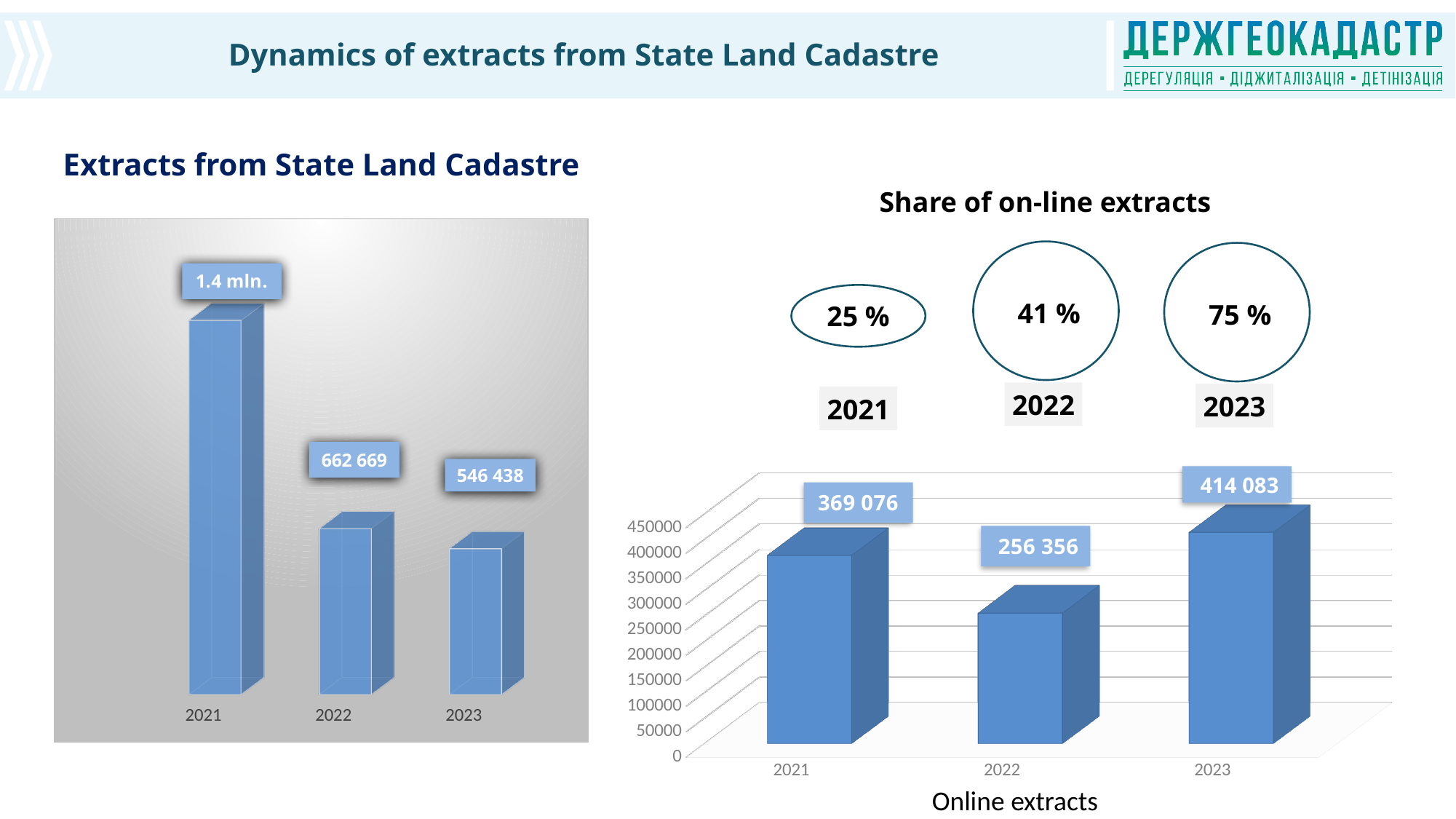
In the 'Extracts from State Land Cadastre' chart, which year has the highest value? 2021 In the 'Extracts from State Land Cadastre' chart, what is the value for 2023? 546 438 In the 'Extracts from State Land Cadastre' chart, what is the value for 2021? 1.4 mln. In the 'Extracts from State Land Cadastre' chart, what is the value for 2022? 662 669 In the 'Online extracts' chart, which year has the lowest value? 2022 In the 'Online extracts' chart, what is the value for 2021? 369 076 In the 'Online extracts' chart, what is the value for 2022? 256 356 What kind of chart is the 'Online extracts' chart? bar chart In the 'Online extracts' chart, is the value for 2021 greater or less than 350000? greater In the 'Online extracts' chart, what is the difference between the 2023 and 2022 values? 157 727 In the 'Extracts from State Land Cadastre' chart, do the values rise or fall from 2021 to 2023? fall In the 'Online extracts' chart, what is the value for 2023? 414 083